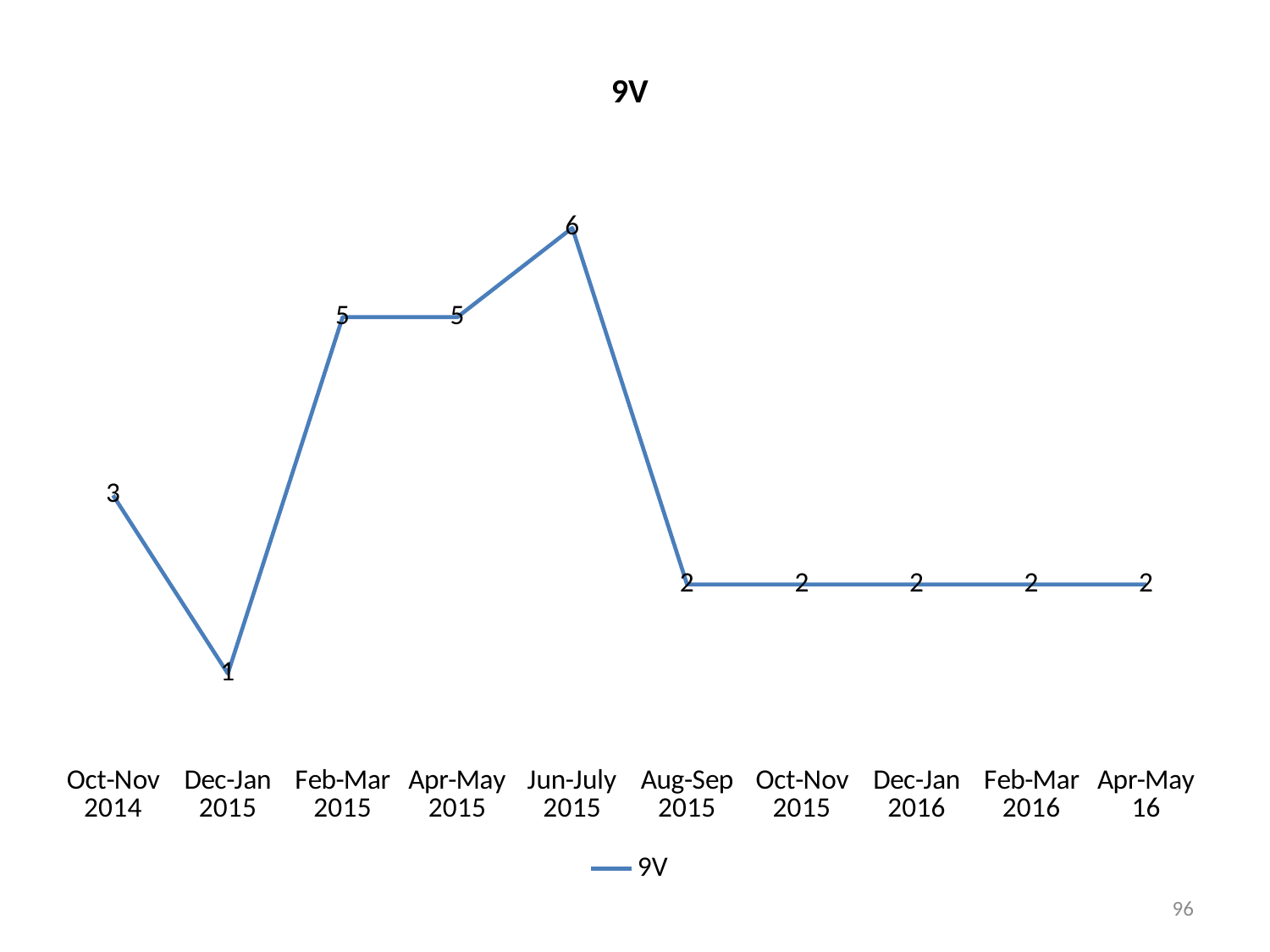
How many periods are plotted on the x axis? 10 What is the value for Oct-Nov 2014? 3 Which is larger, the value for Oct-Nov 2014 or the value for Apr-May 2015? Apr-May 2015 Which period has the highest value? Jun-July 2015 How many series does the legend list? 1 Do the values rise or fall from Jun-July 2015 to Aug-Sep 2015? fall What is the value for Aug-Sep 2015? 2 What kind of chart is shown? line chart Which period has the lowest value? Dec-Jan 2015 What is the value for Feb-Mar 2015? 5 What is the difference between the values for Jun-July 2015 and Aug-Sep 2015? 4 What is the difference between the values for Feb-Mar 2015 and Dec-Jan 2015? 4